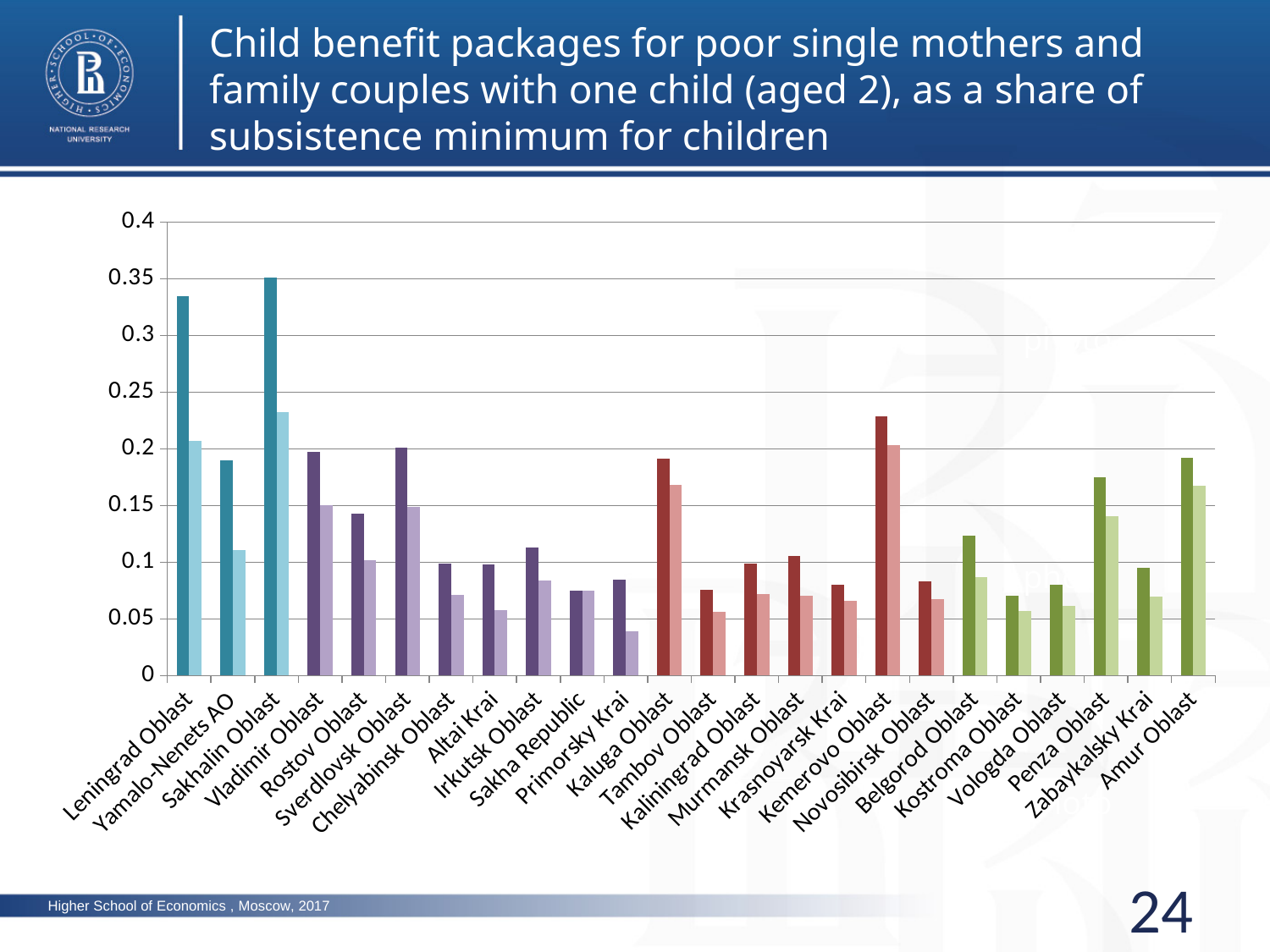
What kind of chart is shown on the slide? bar chart Is the value of the first (darker) bar for Leningrad Oblast greater or less than 0.3? greater Which region has the tallest bar in the chart? Sakhalin Oblast Which region has the shortest bar in the chart? Primorsky Krai Is the value of the first (darker) bar for Penza Oblast greater or less than 0.15? greater What is the highest value shown on the y axis of the chart? 0.4 Is the value of the second (lighter) bar for Primorsky Krai greater or less than 0.05? less Which is larger: the first (darker) bar for Kemerovo Oblast or the first (darker) bar for Kaluga Oblast? Kemerovo Oblast How many regions are listed along the x axis of the chart? 24